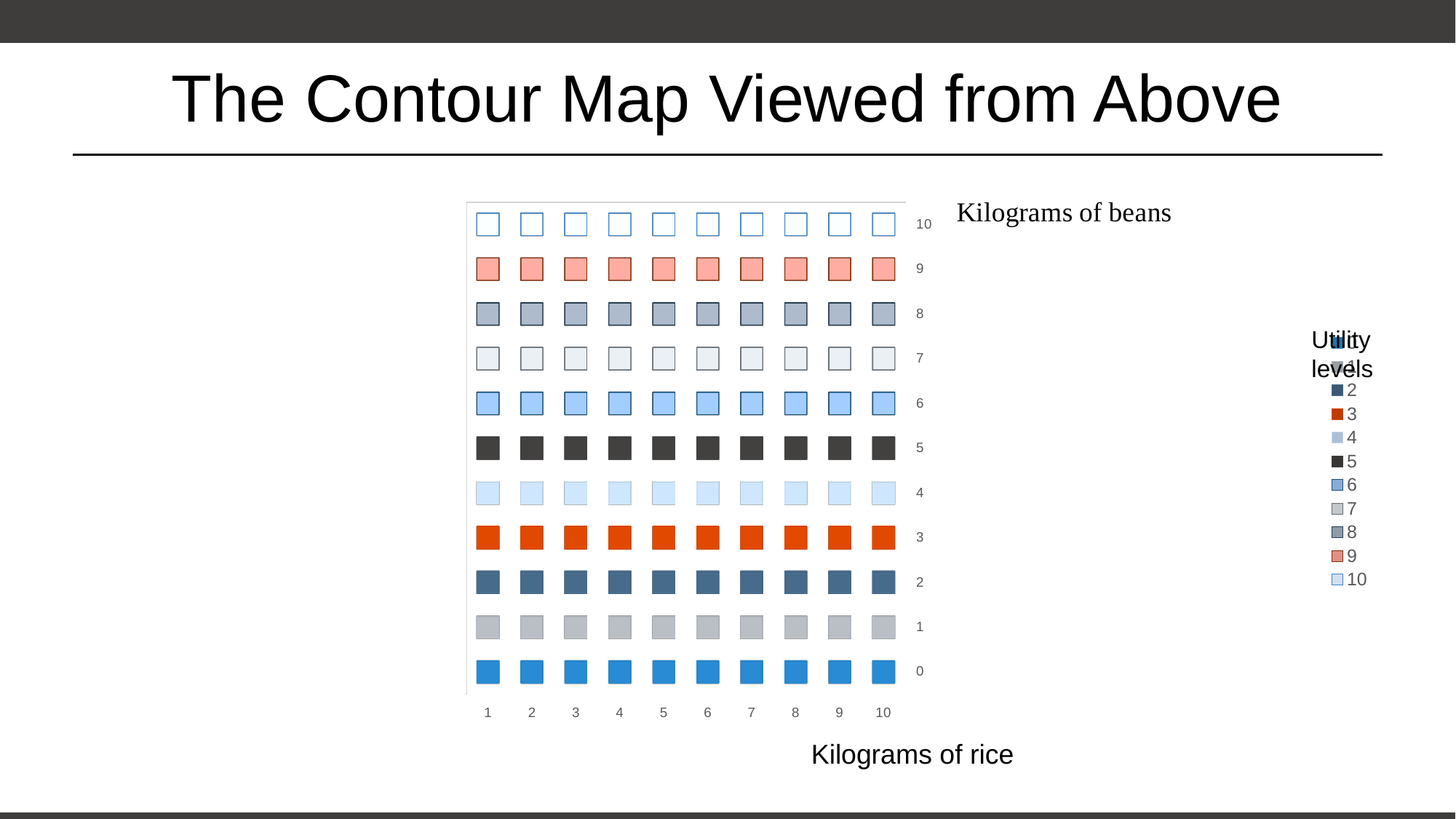
How many horizontal rows of markers does the chart contain? 11 What is the lowest value shown on the vertical axis of the chart? 0 What is the highest value shown on the vertical axis of the chart? 10 What is the title of the chart's legend? Utility levels How many markers are plotted in each horizontal row of the chart? 10 What kind of chart is shown on the slide? surface (contour) chart At what vertical-axis value do the markers for utility level 3 sit? 3 At what vertical-axis value (kilograms of beans) do the markers for utility level 5 sit? 5 What is the label on the horizontal axis of the chart? Kilograms of rice Moving left to right along the horizontal axis, do the markers of a single utility level rise, fall, or stay at the same height? stay at the same height Is the row of markers for utility level 9 higher or lower on the chart than the row for utility level 3? higher What is the highest utility level listed in the legend? 10